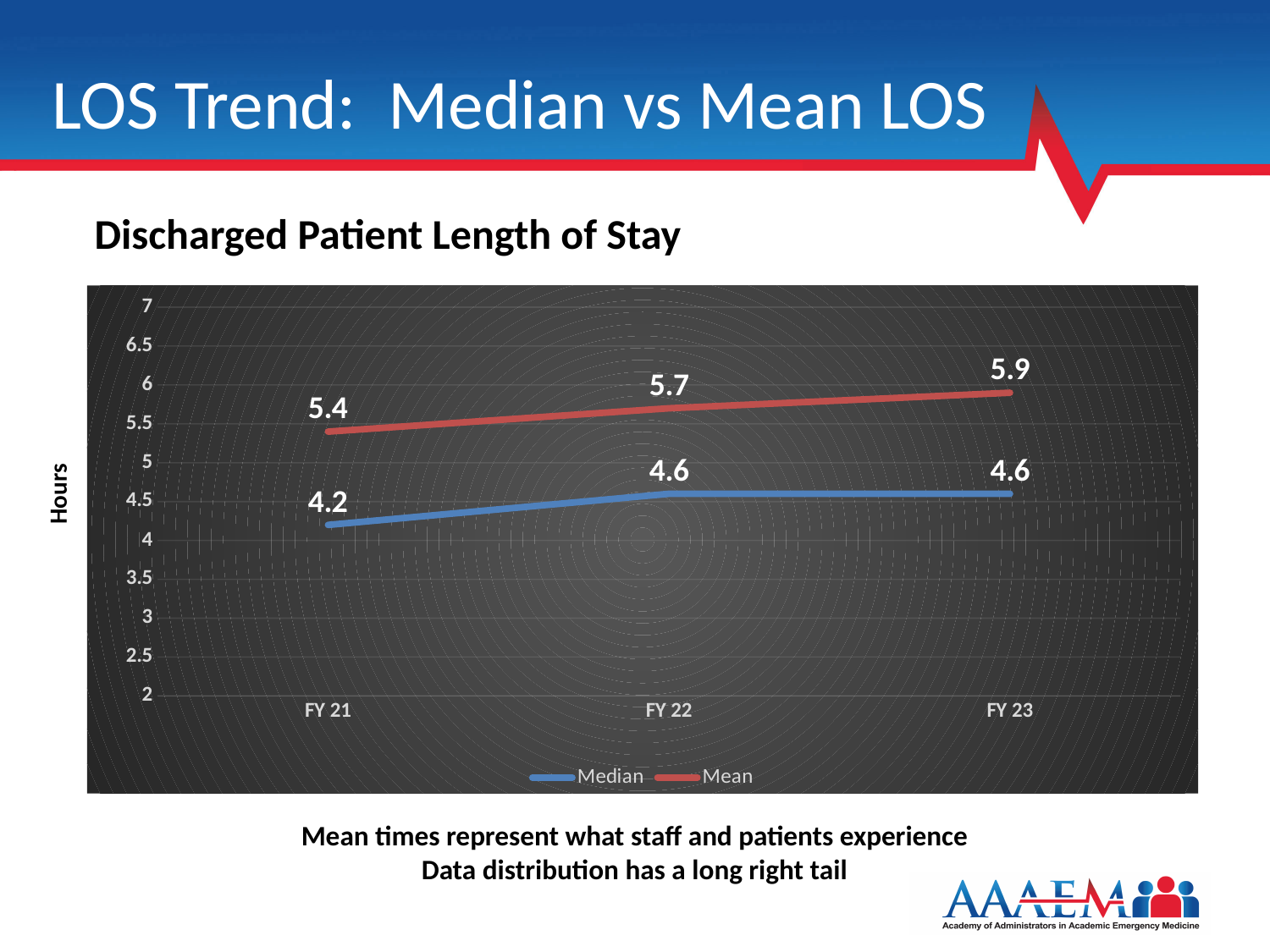
In which fiscal year is the Mean length of stay highest? FY 23 How many series does the legend list? 2 In which fiscal year is the Median length of stay lowest? FY 21 What is the difference between the Mean and Median length of stay in FY 21? 1.2 What is the Median length of stay for FY 21? 4.2 What is the Mean length of stay for FY 22? 5.7 What is the Mean length of stay for FY 23? 5.9 How many fiscal years are shown on the x axis? 3 Which is larger in FY 22, the Mean or the Median length of stay? Mean Does the Mean length of stay rise or fall from FY 21 to FY 23? Rise What kind of chart is shown on the slide? Line chart By how much did the Mean length of stay increase from FY 21 to FY 23? 0.5